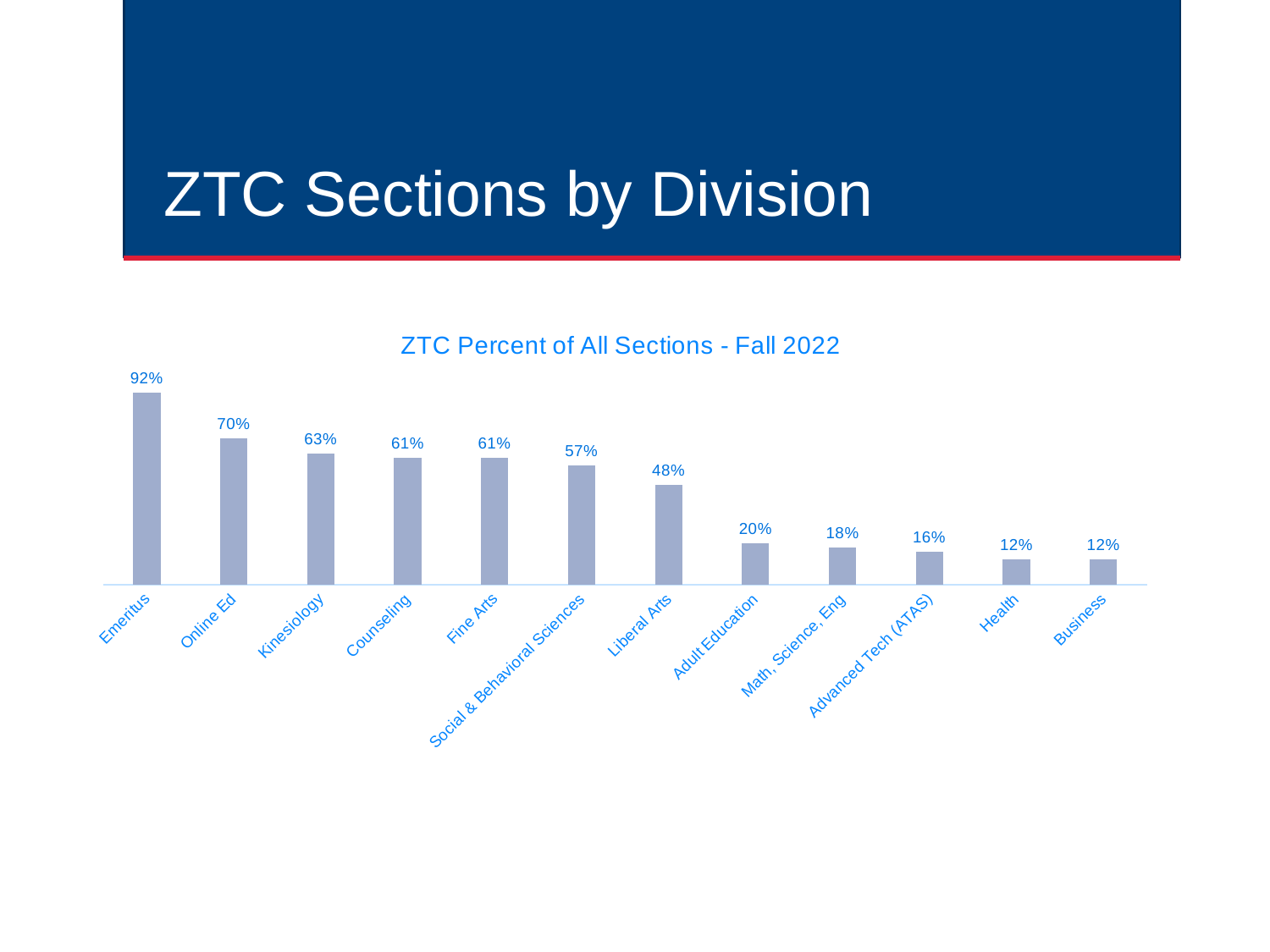
What is the ZTC percent of all sections for Emeritus? 92% What kind of chart is shown on the slide? Bar chart Do the values rise or fall from left to right across the divisions? Fall Which has a higher ZTC percent of all sections, Math, Science, Eng or Liberal Arts? Liberal Arts How many divisions are shown in the chart? 12 Which has a higher ZTC percent of all sections, Social & Behavioral Sciences or Adult Education? Social & Behavioral Sciences What is the difference in ZTC percent between Online Ed and Kinesiology? 7% What is the title of the chart? ZTC Percent of All Sections - Fall 2022 What is the ZTC percent of all sections for Advanced Tech (ATAS)? 16% What is the ZTC percent of all sections for Liberal Arts? 48% Which division has the highest ZTC percent of all sections? Emeritus What is the difference in ZTC percent between Emeritus and Business? 80%